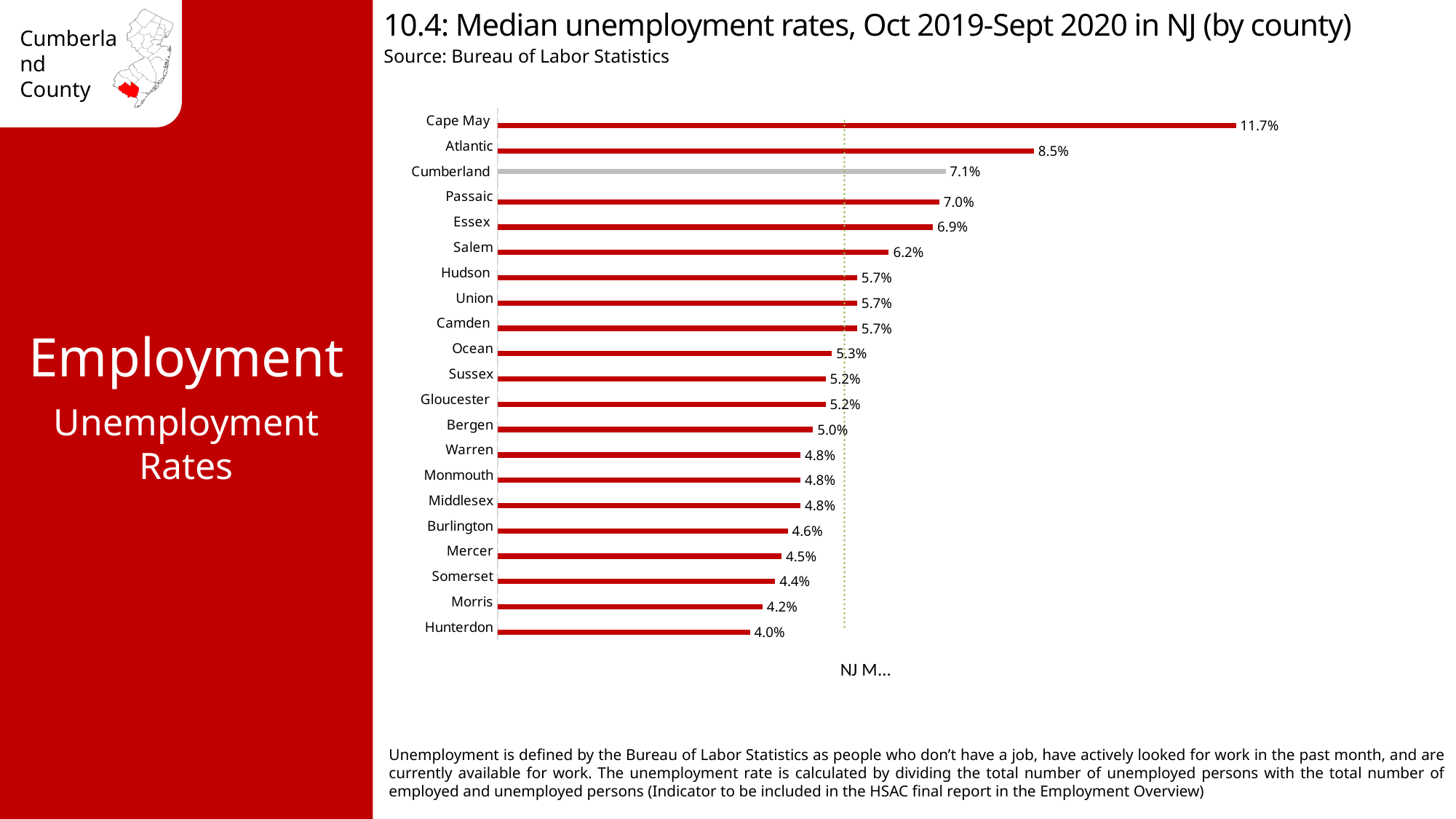
What kind of chart is used to show the median unemployment rates? Bar chart What is the difference between the median unemployment rates of Cape May and Atlantic? 3.2% What is the median unemployment rate for Ocean? 5.3% What is the median unemployment rate for Cumberland County? 7.1% What is the median unemployment rate for Hunterdon? 4.0% What is the median unemployment rate for Cape May? 11.7% Which county has the lowest median unemployment rate? Hunterdon How many counties are shown in the chart? 21 Which county's bar is shown in grey rather than red? Cumberland What is the difference between the median unemployment rates of Cumberland and Hunterdon? 3.1% Which county has a higher median unemployment rate, Salem or Bergen? Salem Which county has the highest median unemployment rate? Cape May